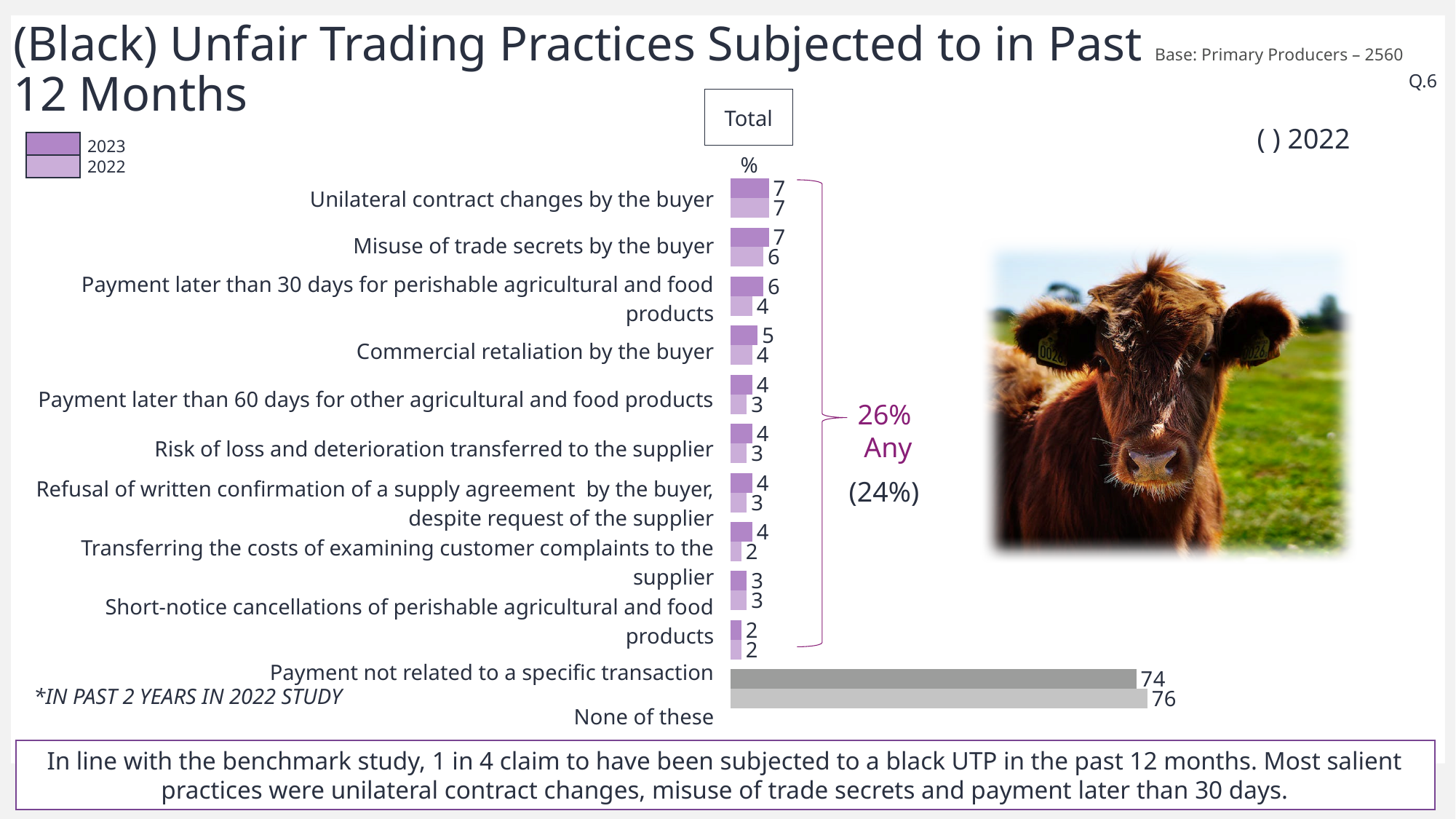
What is the 2023 value for 'Misuse of trade secrets by the buyer'? 7 What is the difference between the 2022 and 2023 values for 'None of these'? 2 What is the 2022 value for 'Transferring the costs of examining customer complaints to the supplier'? 2 Excluding 'None of these', which category has the lowest 2023 value? Payment not related to a specific transaction Is the 2023 value for 'Commercial retaliation by the buyer' larger than its 2022 value? Yes How many series does the legend list? 2 How many categories are shown in the chart? 11 What is the 2022 value for 'Payment later than 30 days for perishable agricultural and food products'? 4 What kind of chart is shown on the slide? Bar chart Which category has the highest 2023 value? None of these What is the 2023 value for 'None of these'? 74 What percentage of primary producers were subjected to any black UTP in 2023, according to the bracket annotation? 26%